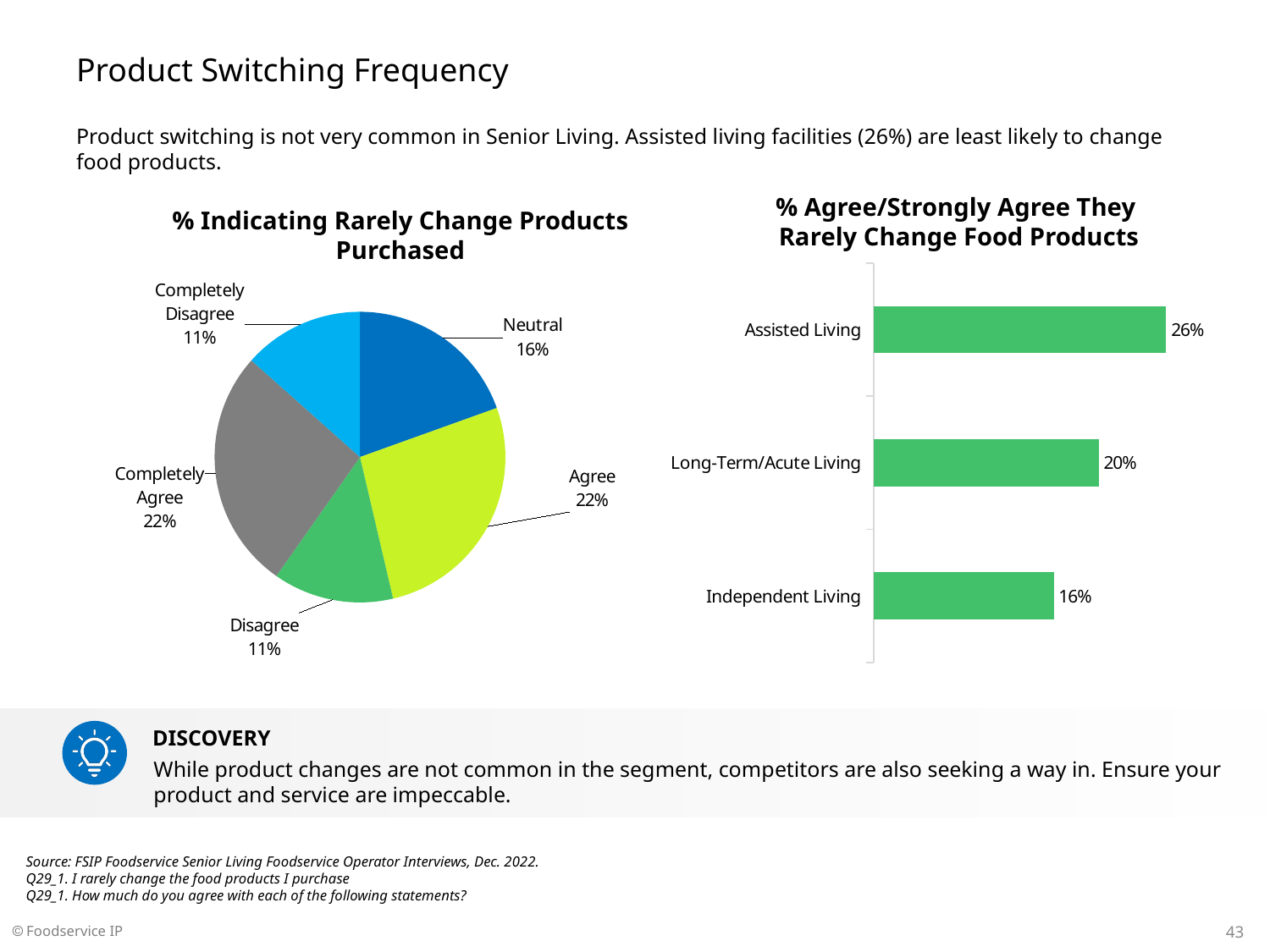
In the pie chart titled '% Indicating Rarely Change Products Purchased', which is larger, Neutral or Completely Agree? Completely Agree In the pie chart titled '% Indicating Rarely Change Products Purchased', what is the difference between the Agree and Disagree percentages? 11% In the pie chart titled '% Indicating Rarely Change Products Purchased', what percentage is shown for Completely Disagree? 11% In the chart titled '% Agree/Strongly Agree They Rarely Change Food Products', which category has the highest value? Assisted Living In the chart titled '% Agree/Strongly Agree They Rarely Change Food Products', what is the value for Long-Term/Acute Living? 20% In the pie chart titled '% Indicating Rarely Change Products Purchased', how many slices are there? 5 In the chart titled '% Agree/Strongly Agree They Rarely Change Food Products', which category has the lowest value? Independent Living In the chart titled '% Agree/Strongly Agree They Rarely Change Food Products', what is the difference between Assisted Living and Independent Living? 10% What type of chart is the one titled '% Agree/Strongly Agree They Rarely Change Food Products'? Bar chart In the pie chart titled '% Indicating Rarely Change Products Purchased', what percentage is shown for Neutral? 16% In the chart titled '% Agree/Strongly Agree They Rarely Change Food Products', what is the value for Assisted Living? 26% In the pie chart titled '% Indicating Rarely Change Products Purchased', what percentage is shown for Completely Agree? 22%